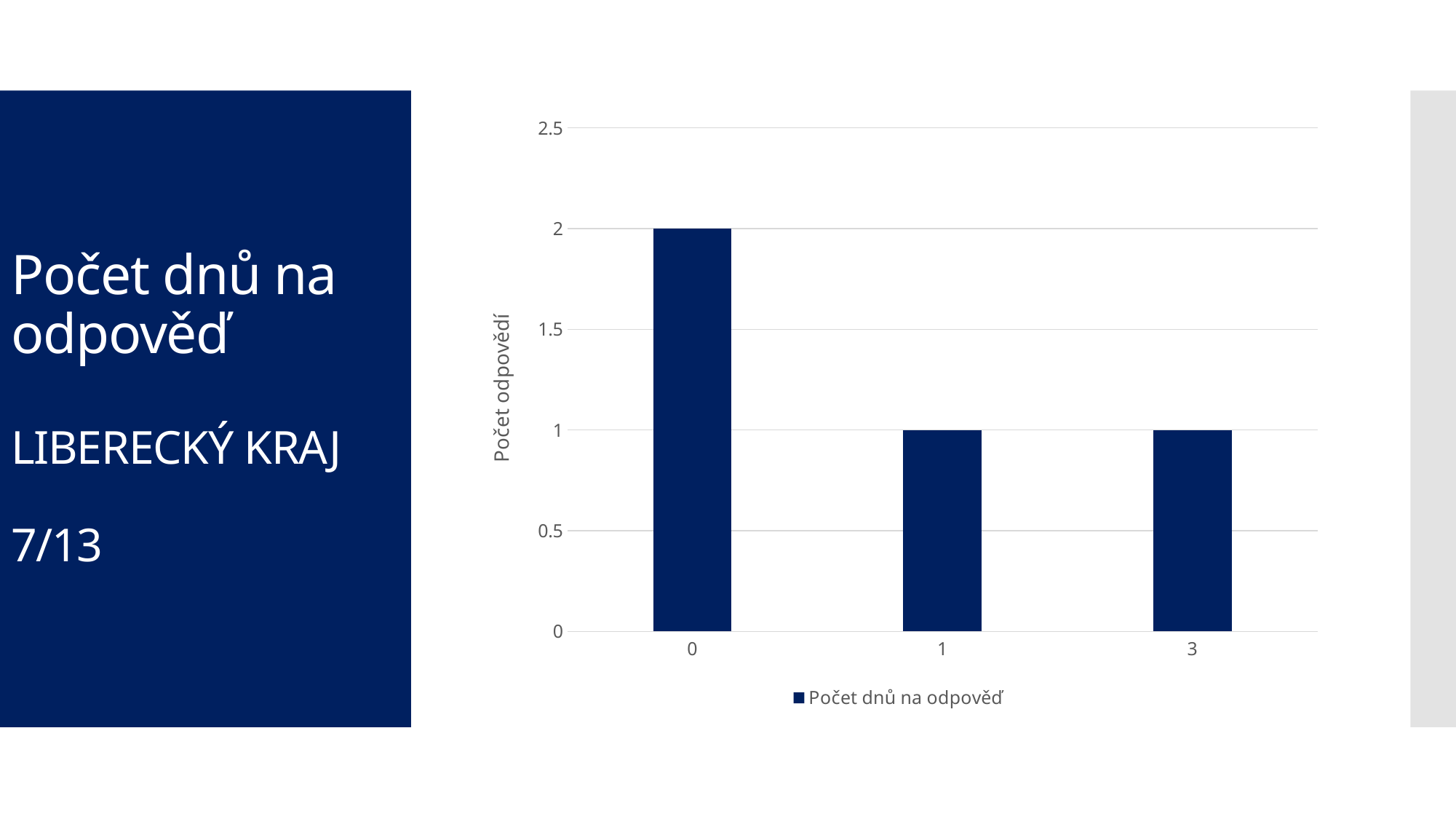
Is the value for category 0 greater or less than 1.5? greater Which category has the highest value? 0 What is the difference between the value for category 0 and the value for category 1? 1 What is the value for category 0? 2 Which is larger, the value for category 0 or the value for category 3? 0 Is the value for category 1 greater or less than 1.5? less What is the value for category 1? 1 What is the label of the y axis? Počet odpovědí What is the value for category 3? 1 How many categories are shown on the x axis? 3 How many series does the legend list? 1 What kind of chart is shown on the slide? bar chart